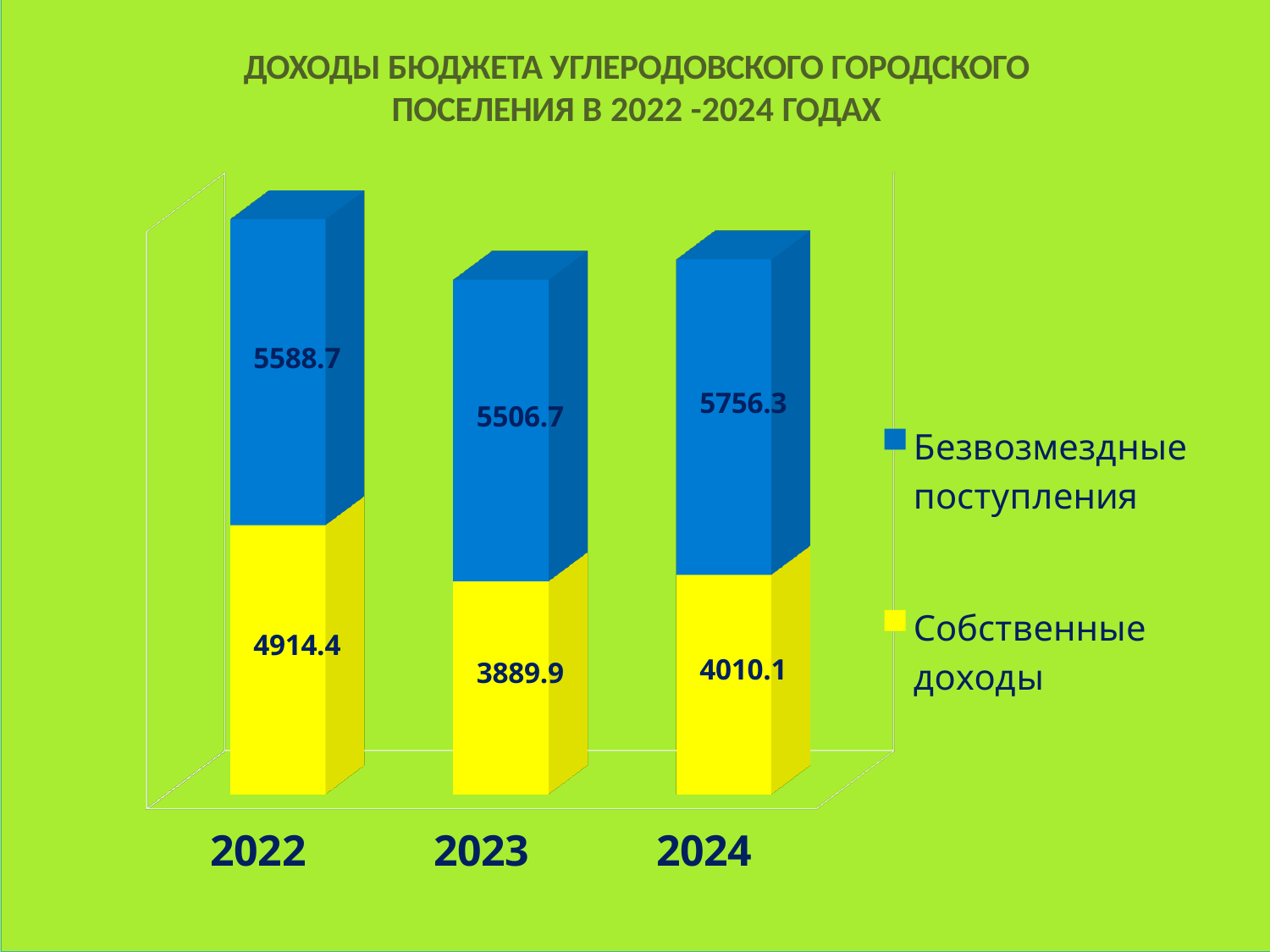
In which year is Собственные доходы the lowest? 2023 In which year is Собственные доходы the highest? 2022 How many years are shown on the x axis? 3 What is the difference between Собственные доходы in 2022 and in 2023? 1024.5 What is the value of Безвозмездные поступления for 2022? 5588.7 What kind of chart is shown on the slide? Stacked bar chart What is the value of Собственные доходы for 2023? 3889.9 What is the total of the stacked bar for 2023? 9396.6 What is the value of Собственные доходы for 2024? 4010.1 In which year is Безвозмездные поступления the highest? 2024 How many series does the legend list? 2 Which is larger: Безвозмездные поступления in 2022 or in 2023? 2022